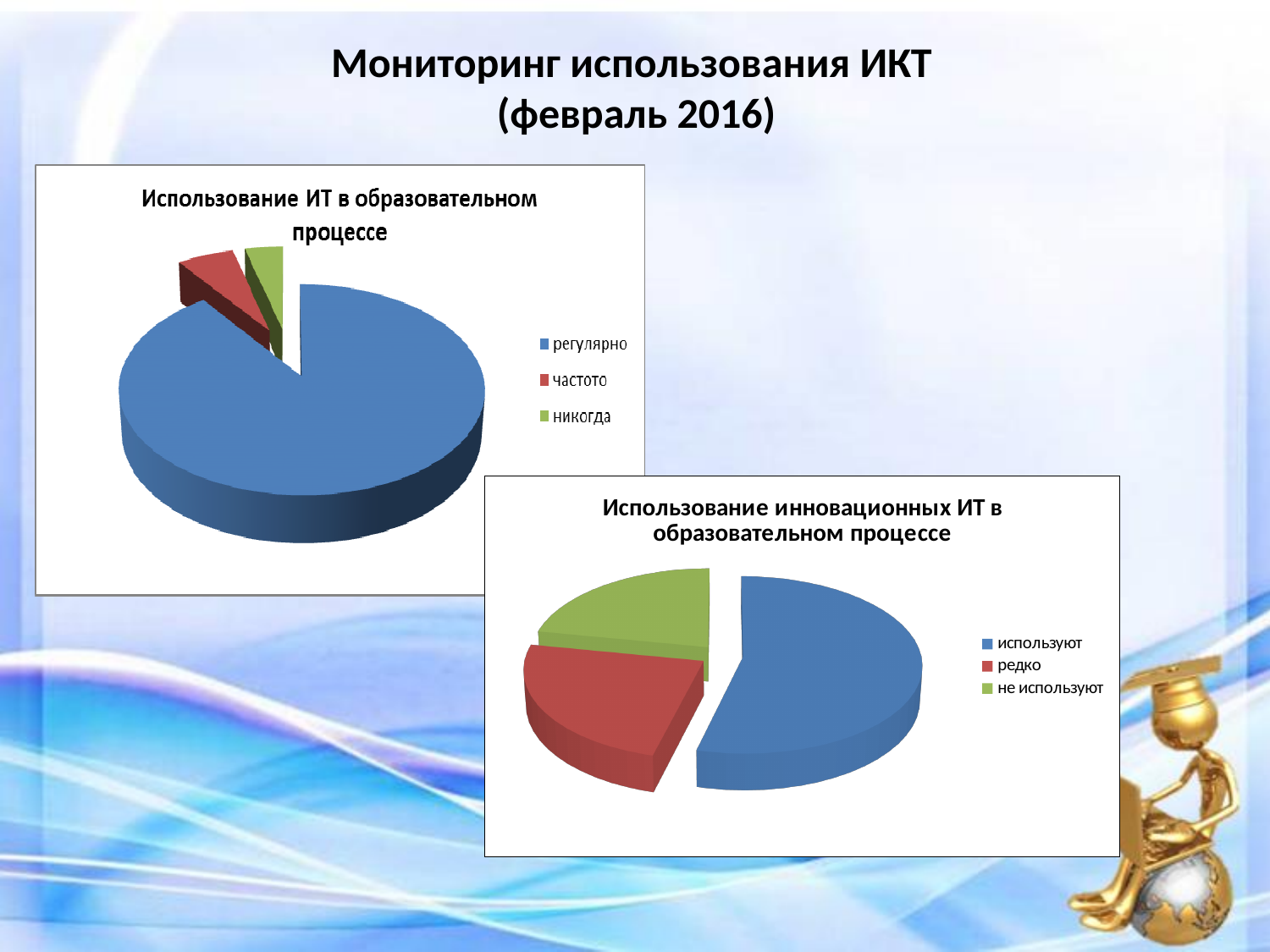
What kind of chart is the chart titled "Использование ИТ в образовательном процессе"? pie chart In the chart titled "Использование инновационных ИТ в образовательном процессе", which category has the largest slice? используют In the chart titled "Использование инновационных ИТ в образовательном процессе", which category has the smallest slice? не используют In the chart titled "Использование ИТ в образовательном процессе", which category has the smallest slice? никогда What is the title of the chart in the lower right of the slide? Использование инновационных ИТ в образовательном процессе In the chart titled "Использование ИТ в образовательном процессе", which category has the largest slice? регулярно In the chart titled "Использование ИТ в образовательном процессе", which slice is larger: частото or никогда? частото In the chart titled "Использование инновационных ИТ в образовательном процессе", which slice is larger: используют or редко? используют In the chart titled "Использование ИТ в образовательном процессе", how many slices does the pie have? 3 In the chart titled "Использование инновационных ИТ в образовательном процессе", how many categories does the legend list? 3 What kind of chart is the chart titled "Использование инновационных ИТ в образовательном процессе"? pie chart In the chart titled "Использование ИТ в образовательном процессе", what colour is the slice for никогда? green